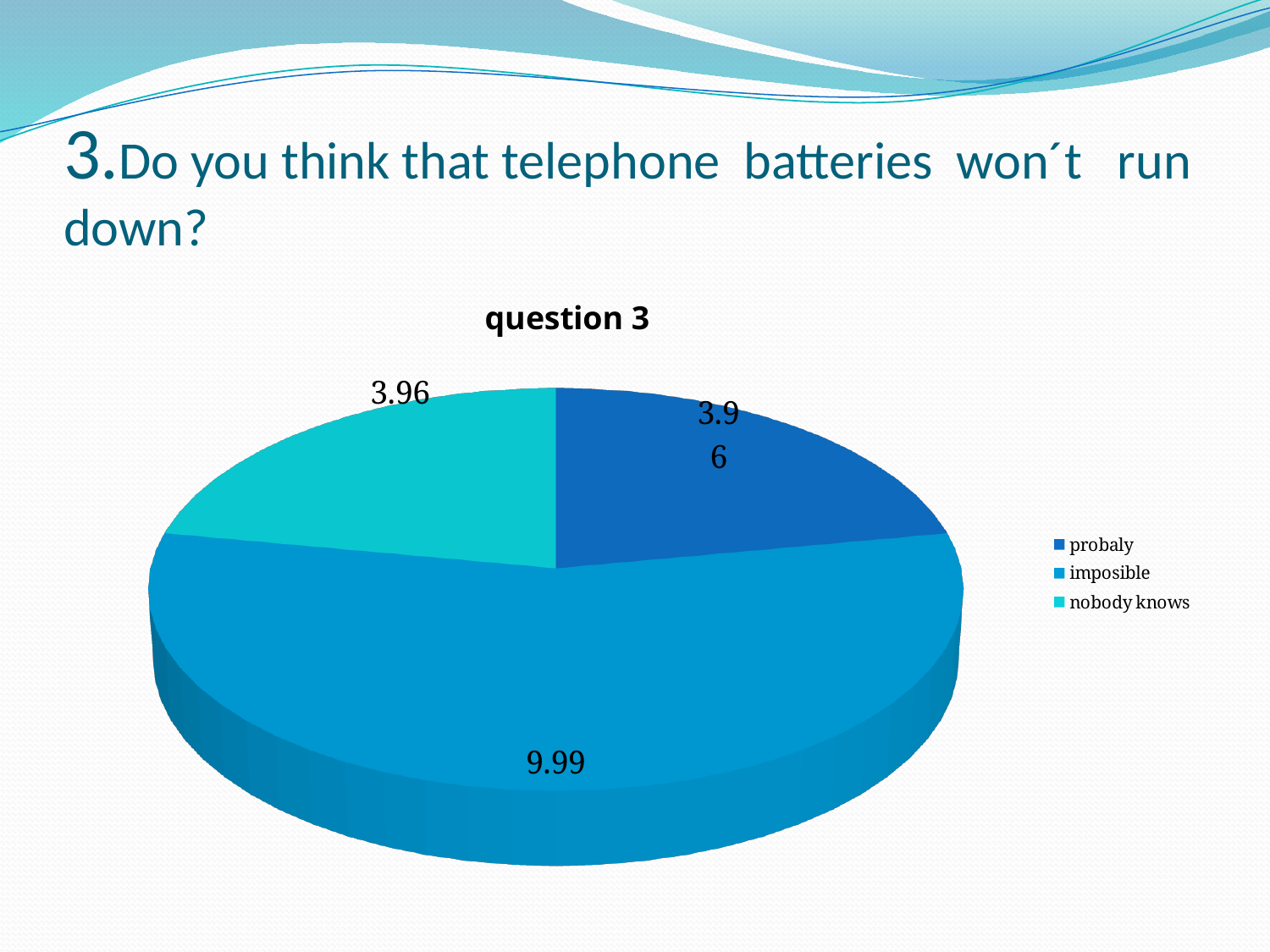
Which is larger, 'imposible' or 'nobody knows'? imposible How many slices does the pie chart have? 3 What is the value for 'nobody knows'? 3.96 How many entries does the legend list? 3 Which legend entry is shown in the darkest blue colour? probaly What is the total of all three slice values? 17.91 What is the value for 'imposible'? 9.99 What is the title of the chart? question 3 What is the difference between the values for 'imposible' and 'probaly'? 6.03 What is the value for 'probaly'? 3.96 What type of chart is shown on the slide? pie chart Which category has the largest slice? imposible